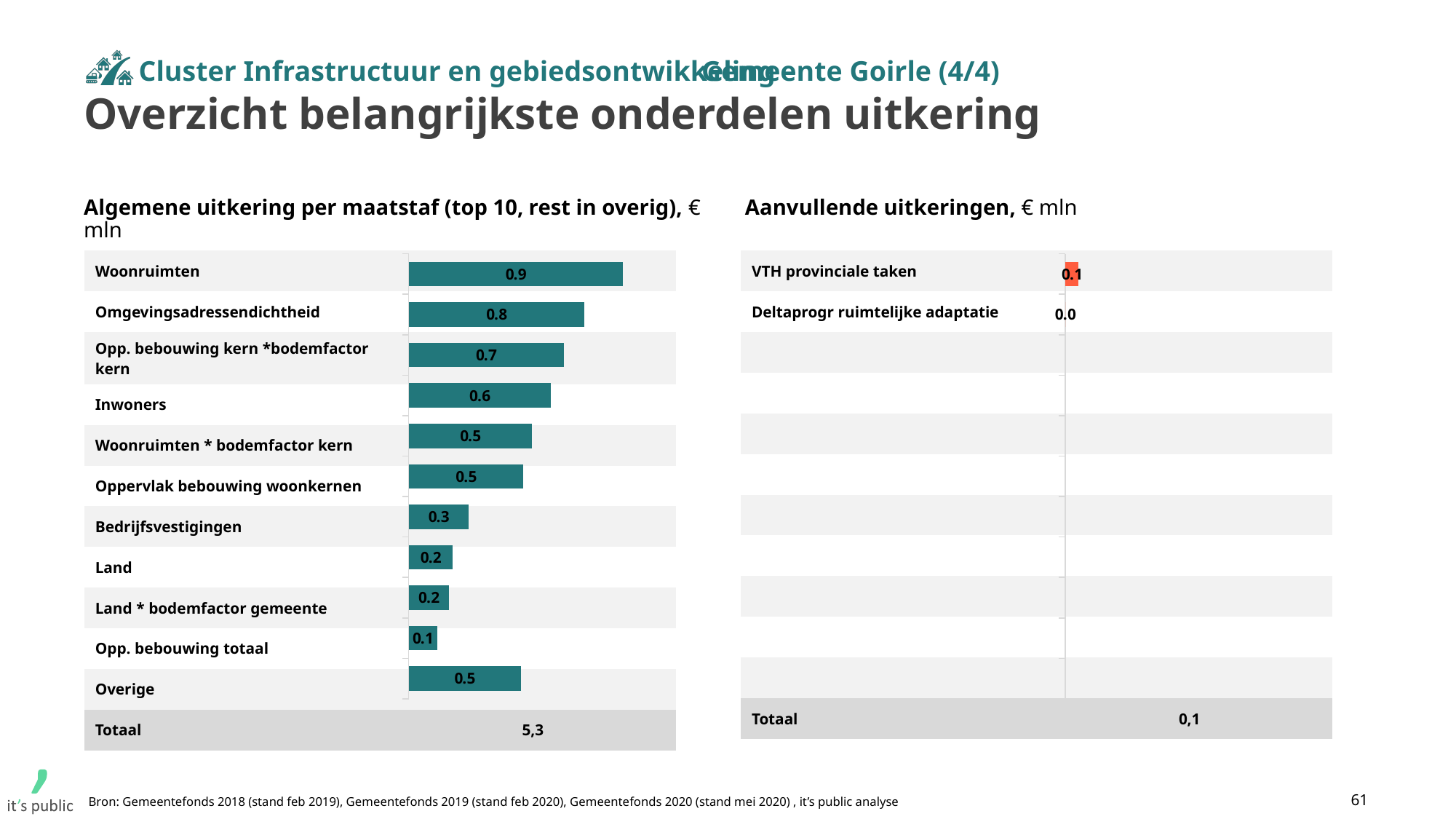
In the 'Aanvullende uitkeringen' chart, what is the value for VTH provinciale taken? 0.1 How many bars are shown in the 'Algemene uitkering per maatstaf' chart? 11 In the 'Algemene uitkering per maatstaf' chart, which category has the lowest value? Opp. bebouwing totaal In the 'Algemene uitkering per maatstaf' chart, what is the value for Bedrijfsvestigingen? 0.3 In the 'Algemene uitkering per maatstaf' chart, what is the difference between Woonruimten and Omgevingsadressendichtheid? 0.1 In the 'Algemene uitkering per maatstaf' chart, which category has the highest value? Woonruimten In the 'Algemene uitkering per maatstaf' chart, what is the value for Woonruimten? 0.9 In the 'Algemene uitkering per maatstaf' chart, which is larger: Inwoners or Bedrijfsvestigingen? Inwoners In the 'Algemene uitkering per maatstaf' chart, what is the value for Inwoners? 0.6 What type of chart is the 'Algemene uitkering per maatstaf' chart? Bar chart In the 'Aanvullende uitkeringen' chart, what is the value for Deltaprogr ruimtelijke adaptatie? 0.0 What is the total shown for the 'Algemene uitkering per maatstaf' chart? 5,3